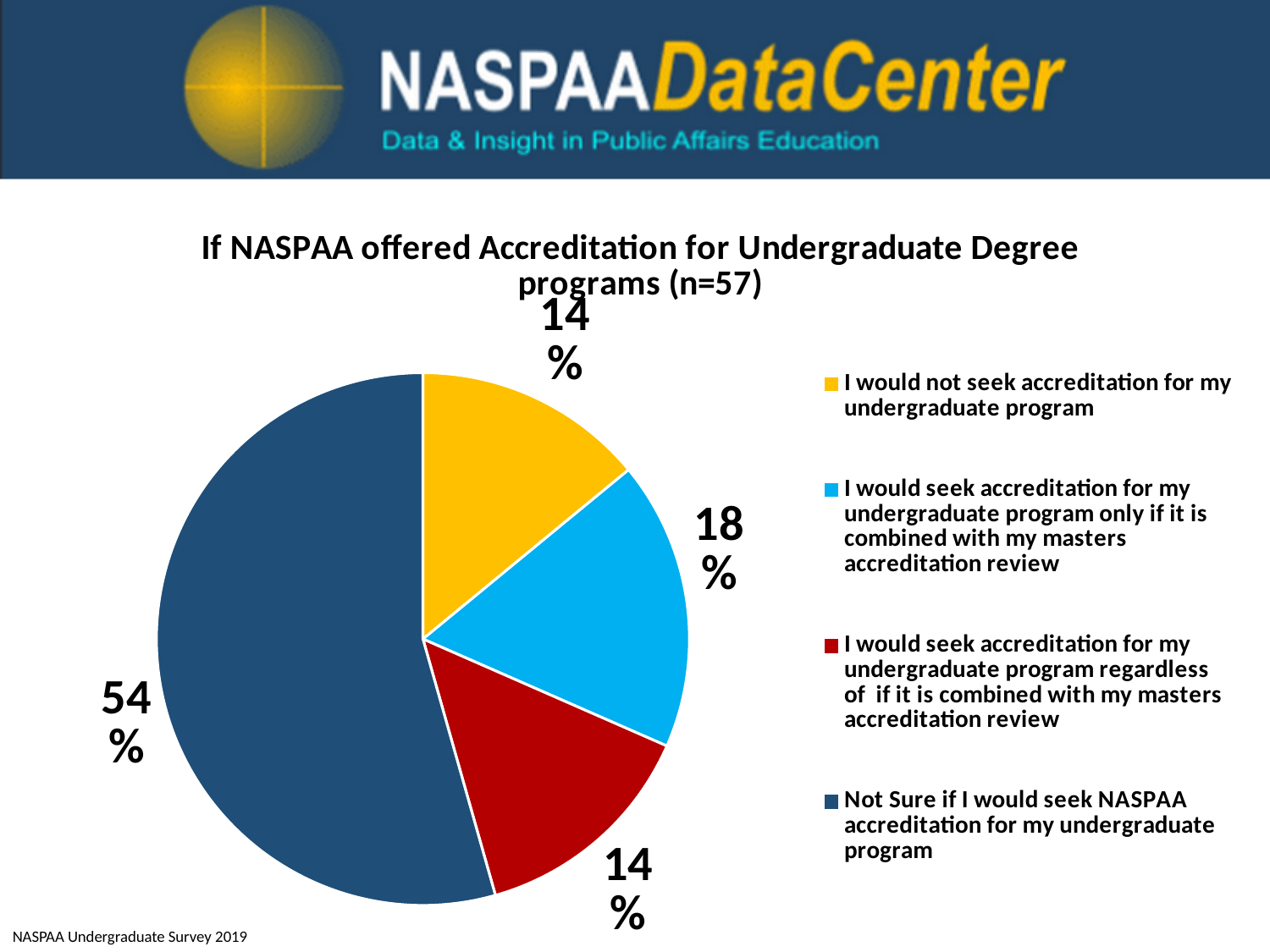
What share of respondents said they would seek accreditation for their undergraduate program regardless of whether it is combined with their masters accreditation review? 14% Which is larger: the share that would seek accreditation only if combined with the masters review, or the share that would not seek accreditation? only if combined with my masters accreditation review How many slices does the pie chart have? 4 How many entries does the legend list? 4 What share of respondents said they would seek accreditation for their undergraduate program only if it is combined with their masters accreditation review? 18% What is the sample size (n) given in the chart title? 57 What colour is the slice for 'Not Sure if I would seek NASPAA accreditation for my undergraduate program'? dark blue What is the difference in percentage points between the 'Not Sure' share and the 'only if combined with my masters accreditation review' share? 36 What share of respondents said they would not seek accreditation for their undergraduate program? 14% What kind of chart is shown on the slide? pie chart What share of respondents said they are not sure if they would seek NASPAA accreditation for their undergraduate program? 54% Which response has the largest share of the pie? Not Sure if I would seek NASPAA accreditation for my undergraduate program